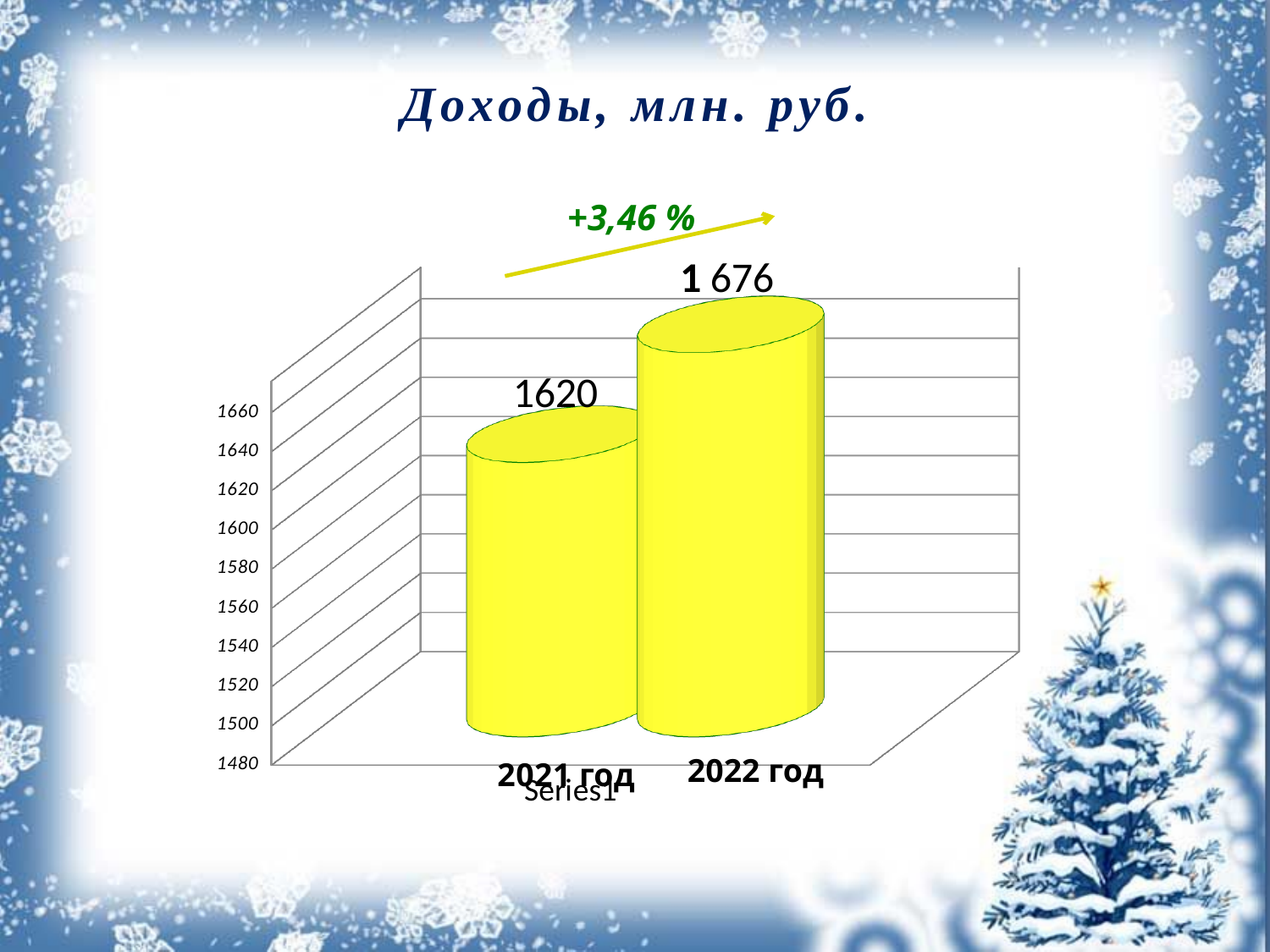
Which year has the higher value? 2022 год Is the value for 2021 год greater or less than 1600? greater What is the value for 2022 год? 1 676 By how much does the value for 2022 год exceed the value for 2021 год? 56 Do the values rise or fall from 2021 год to 2022 год? rise Which year has the lower value? 2021 год What is the value for 2021 год? 1620 How many categories are shown on the chart? 2 What is the title of the chart? Доходы, млн. руб. Is the value for 2021 год or 2022 год larger? 2022 год What kind of chart is shown on the slide? bar chart What percentage change is annotated above the bars? +3,46 %